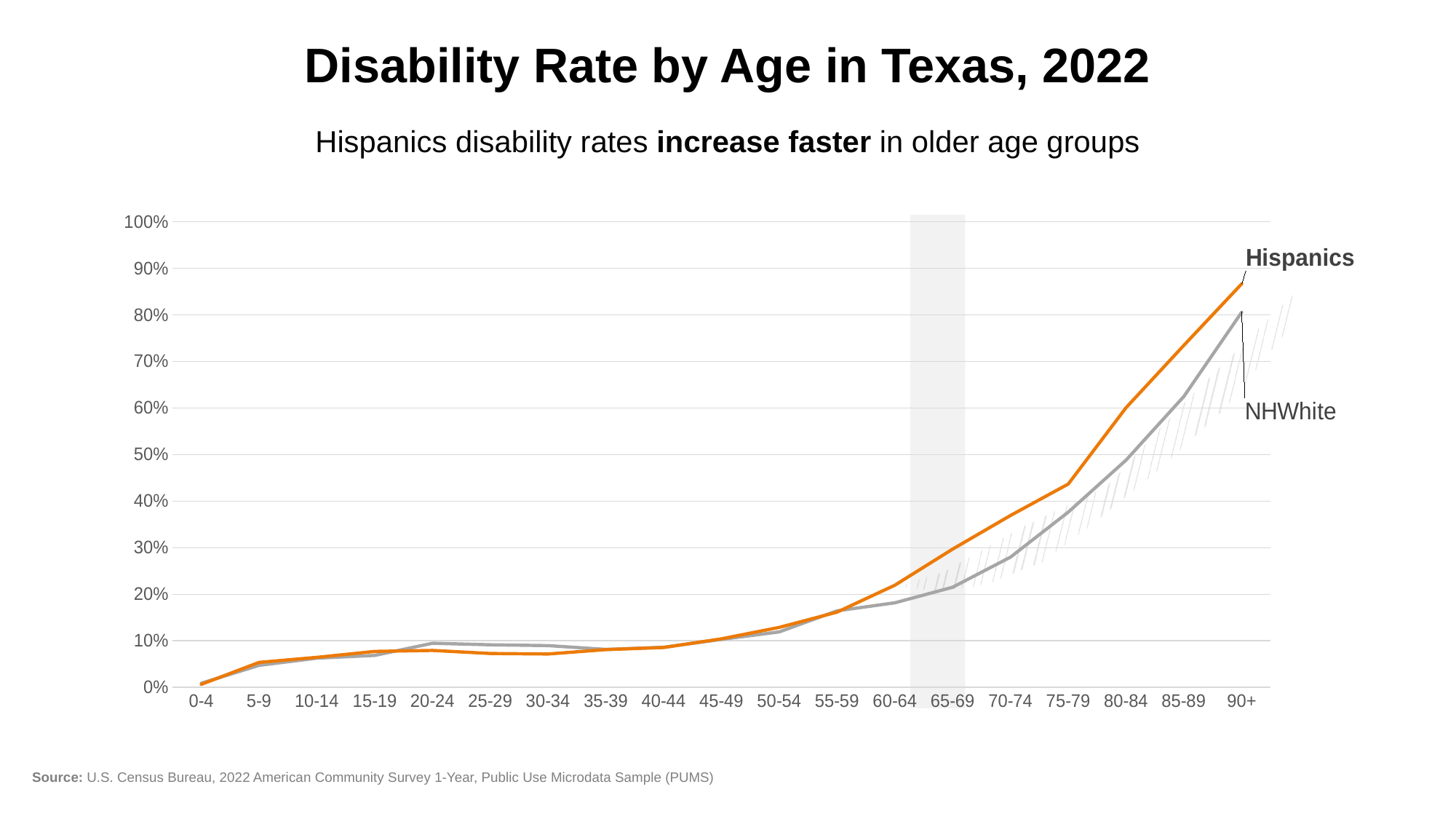
In the 80-84 age group, which series has the higher disability rate, Hispanics or NHWhite? Hispanics Which age group has the lowest disability rate for Hispanics? 0-4 How many series are plotted on the chart? 2 How many age groups are shown along the x axis? 19 Is the disability rate for Hispanics in the 90+ age group greater or less than 80%? greater What kind of chart is shown on the slide? line chart Do the disability rates for Hispanics generally rise or fall as age increases along the x axis? rise Which age group has the highest disability rate for Hispanics? 90+ In the 90+ age group, which series has the higher disability rate, Hispanics or NHWhite? Hispanics Is the disability rate for Hispanics in the 75-79 age group greater or less than 50%? less What is the title of the chart? Disability Rate by Age in Texas, 2022 Is the disability rate for NHWhite in the 70-74 age group greater or less than 40%? less